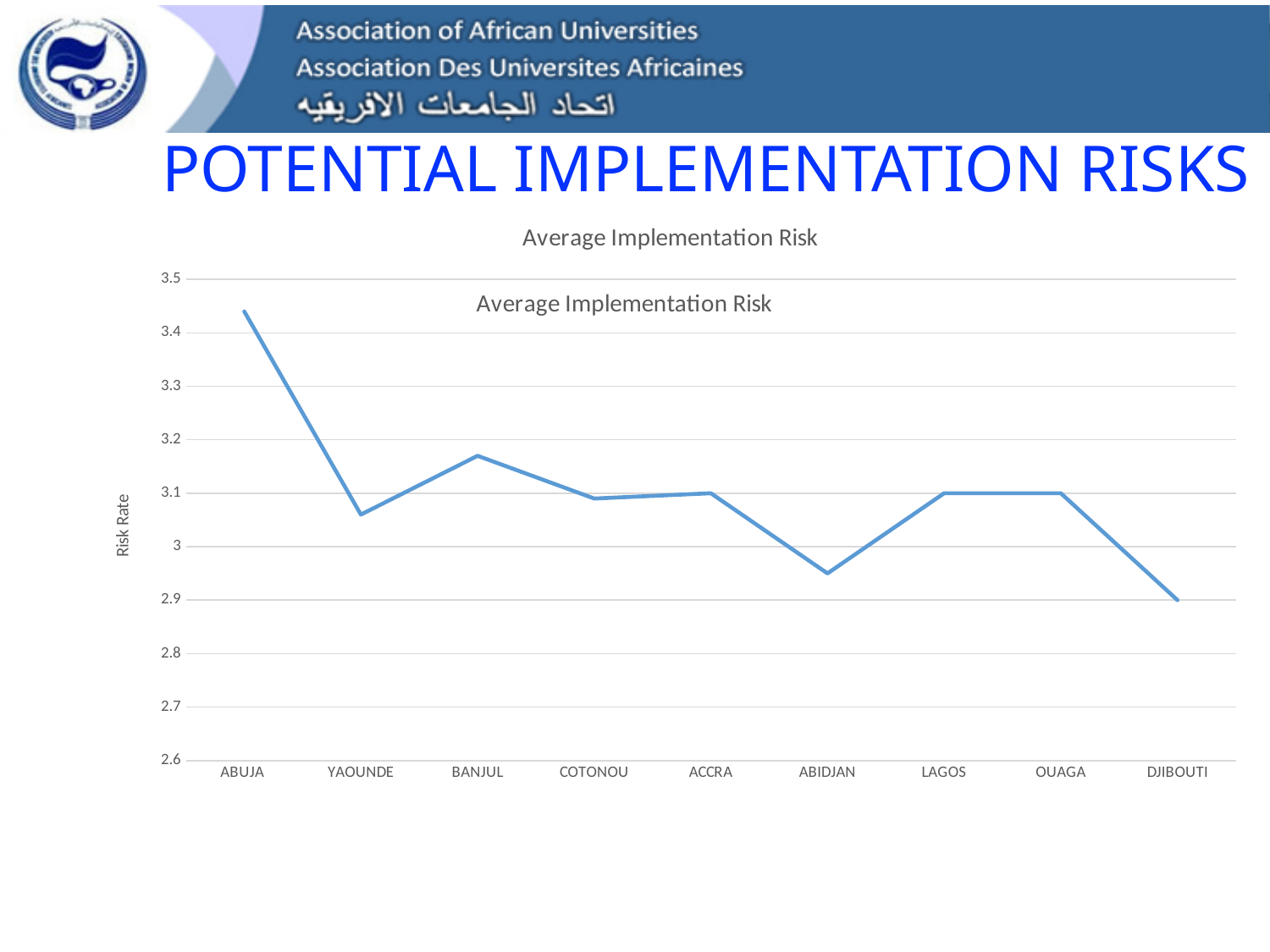
Which has a lower risk rate, ABIDJAN or LAGOS? ABIDJAN What is the risk rate for LAGOS? 3.1 What is the label on the vertical axis of the chart? Risk Rate Is the value for ABIDJAN greater or less than 3? less Is the value for ABUJA greater or less than 3.4? greater What is the risk rate for DJIBOUTI? 2.9 Which has a higher risk rate, ABUJA or BANJUL? ABUJA What kind of chart is shown on the slide? line chart Is the value for BANJUL greater or less than 3.1? greater Which city has the highest average implementation risk? ABUJA How many cities are plotted along the x axis of the chart? 9 Which city has the lowest average implementation risk? DJIBOUTI